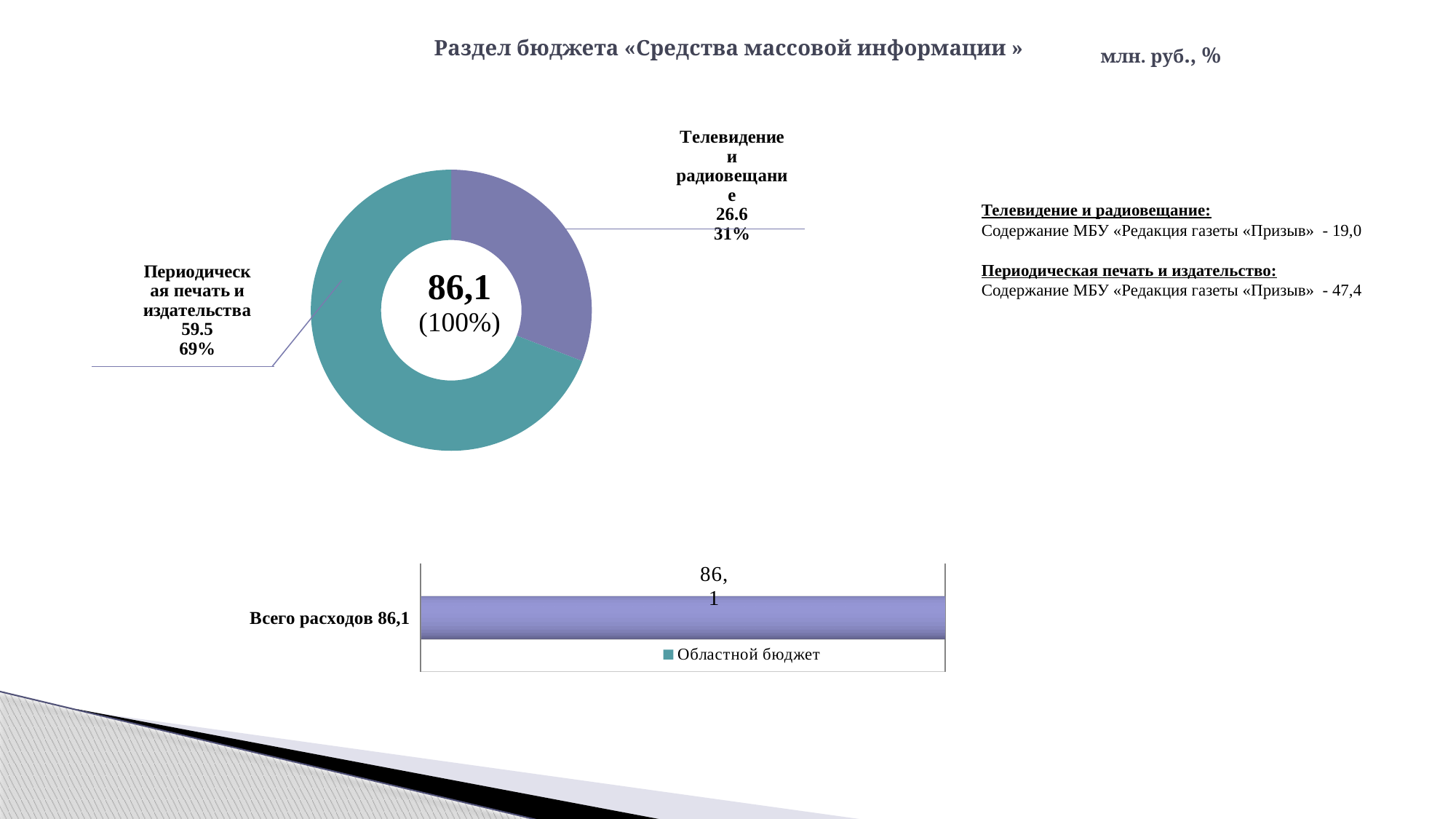
In the donut chart at the top of the slide, which category has the largest value? Периодическая печать и издательства In the donut chart at the top of the slide, what percentage share does Телевидение и радиовещание have? 31% In the donut chart at the top of the slide, how many categories are shown? 2 In the bar chart at the bottom of the slide, what value is labelled on the bar for Всего расходов? 86,1 What kind of chart is shown at the bottom of the slide? bar chart In the donut chart at the top of the slide, which category has the smallest value? Телевидение и радиовещание What total value is printed in the centre of the donut chart at the top of the slide? 86,1 (100%) In the donut chart at the top of the slide, what value is shown for Телевидение и радиовещание? 26.6 In the donut chart at the top of the slide, what is the difference between the values for Периодическая печать и издательства and Телевидение и радиовещание? 32.9 In the bar chart at the bottom of the slide, what series does the legend list? Областной бюджет In the donut chart at the top of the slide, what percentage share does Периодическая печать и издательства have? 69% In the donut chart at the top of the slide, what value is shown for Периодическая печать и издательства? 59.5